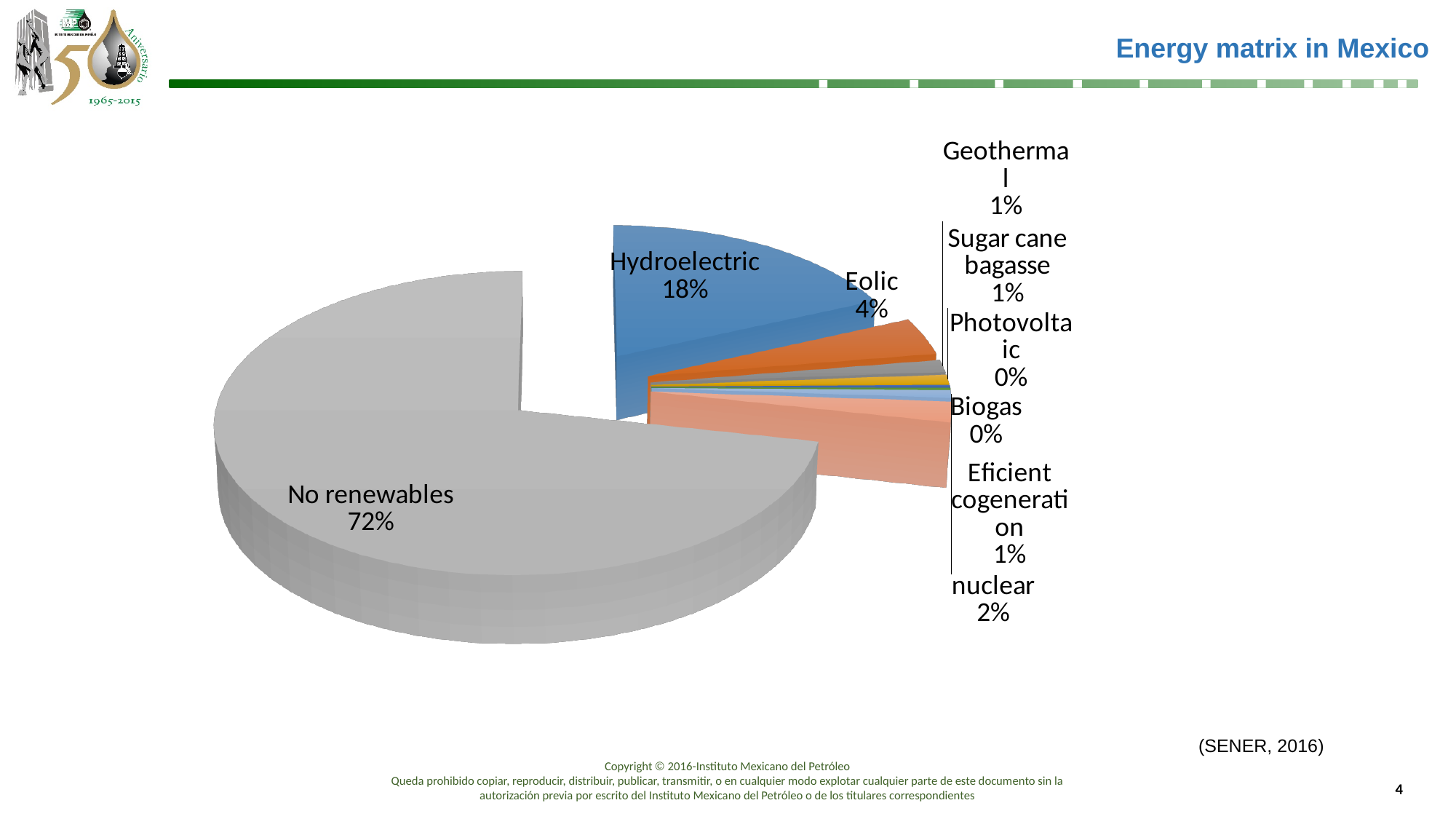
What percentage is shown for Photovoltaic? 0% What percentage is shown for Eolic? 4% How many percentage points larger is Hydroelectric than Eolic? 14 Which is larger, the share for Eolic or the share for nuclear? Eolic How many categories are shown in the pie chart? 9 What percentage is shown for nuclear? 2% What share of the pie does No renewables account for? 72% How many percentage points larger is No renewables than Hydroelectric? 54 What kind of chart is shown on the slide? Pie chart Which category has the largest slice of the pie? No renewables What share of the pie does Hydroelectric account for? 18% What percentage is shown for Sugar cane bagasse? 1%